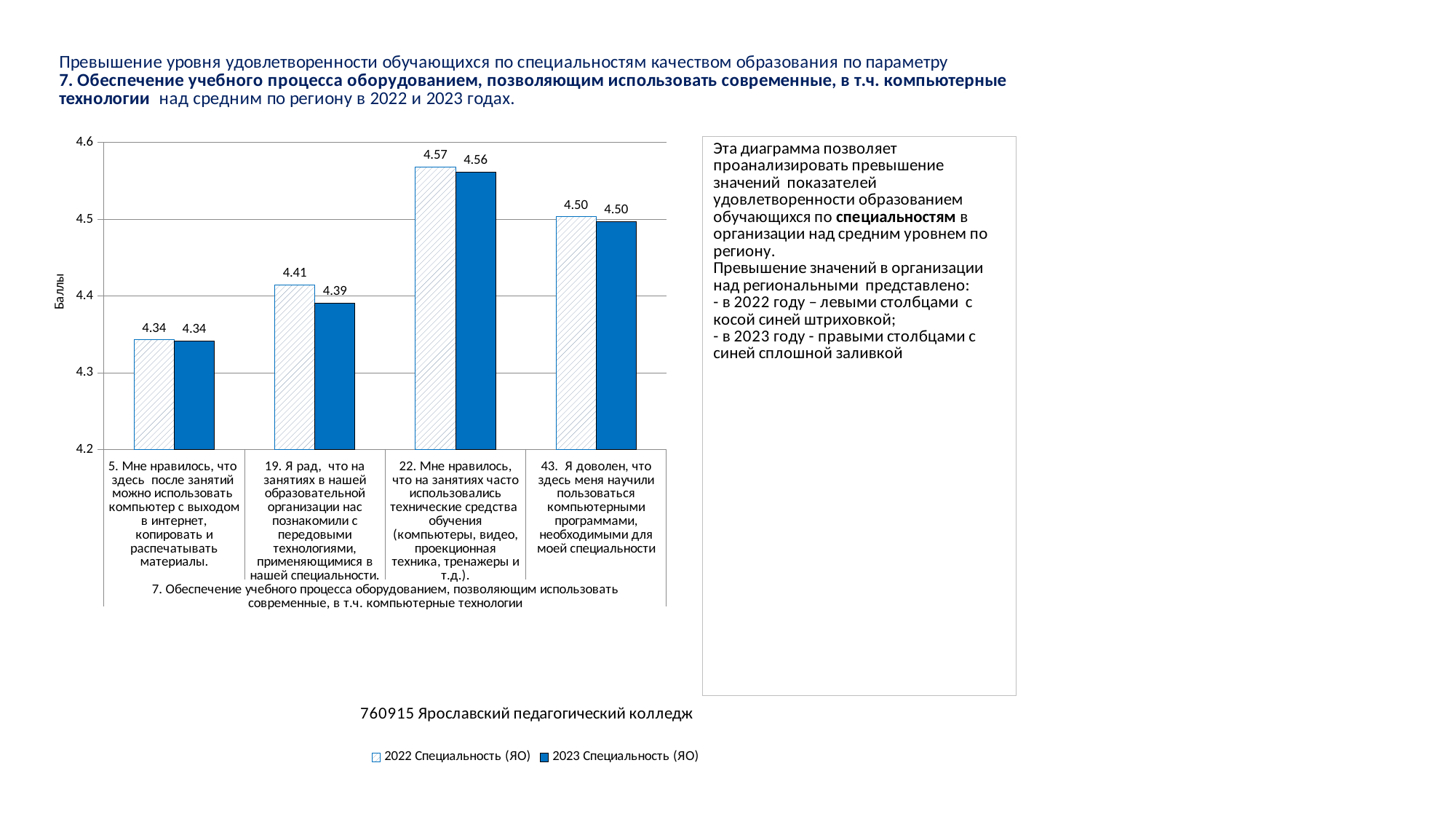
What is the difference between the 2022 and 2023 values for category 19? 0.02 What is the 2022 Специальность (ЯО) value for category 22 (Мне нравилось, что на занятиях часто использовались технические средства обучения)? 4.57 What is the 2023 Специальность (ЯО) value for category 43 (Я доволен, что здесь меня научили пользоваться компьютерными программами)? 4.50 How many categories are shown on the x axis? 4 How many series does the legend list? 2 Which is larger for category 22: the 2022 value or the 2023 value? 2022 (4.57) What is the difference between the 2022 values for category 22 and category 5? 0.23 Which category has the lowest 2023 Специальность (ЯО) value? 5. Мне нравилось, что здесь после занятий можно использовать компьютер с выходом в интернет Is the 2022 value for category 43 greater or less than 4.4? greater Which category has the highest 2022 Специальность (ЯО) value? 22. Мне нравилось, что на занятиях часто использовались технические средства обучения What type of chart is shown on the slide? Bar chart What is the 2023 Специальность (ЯО) value for category 19 (Я рад, что на занятиях в нашей образовательной организации нас познакомили с передовыми технологиями)? 4.39